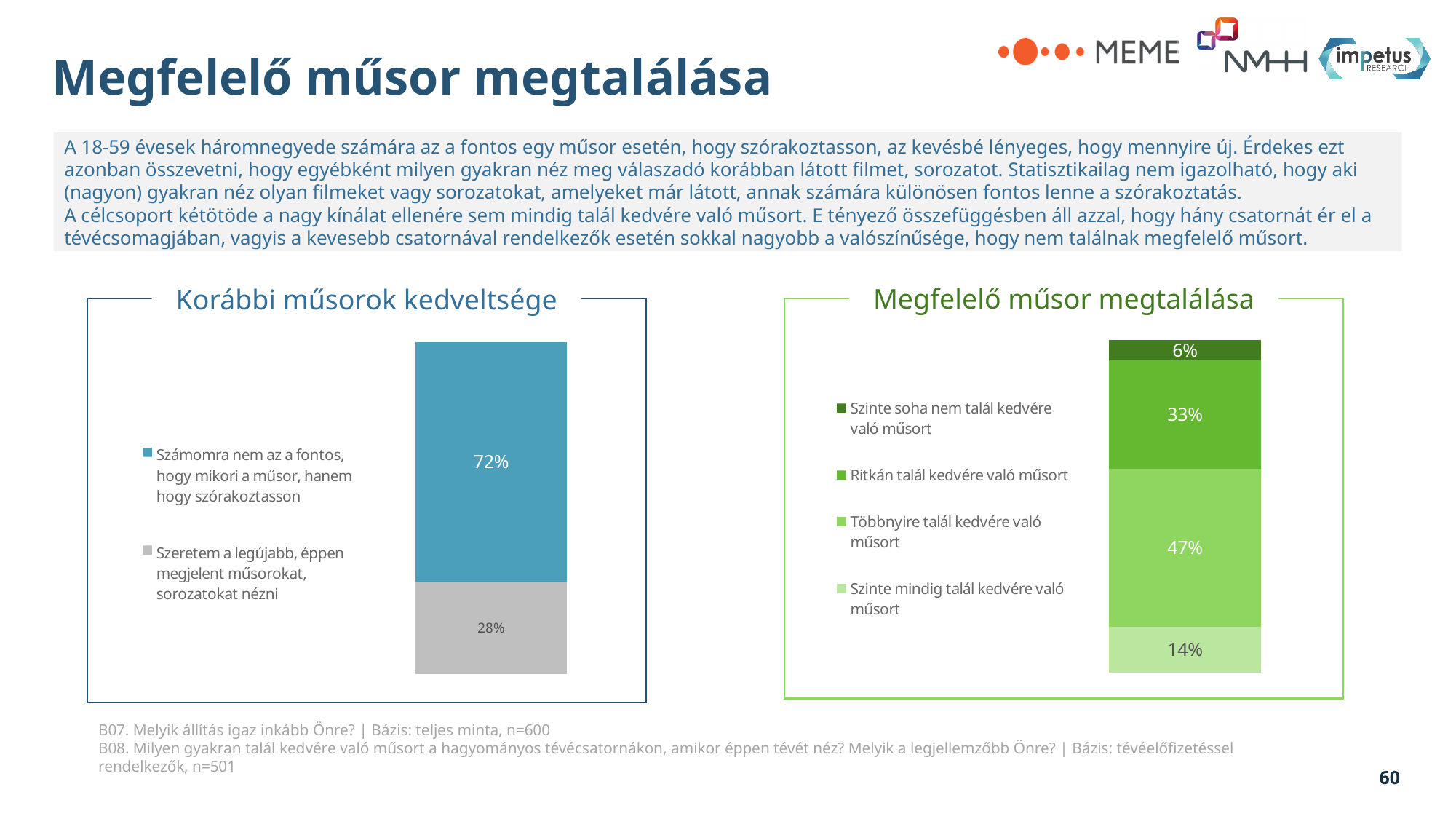
In the chart titled "Megfelelő műsor megtalálása", what percentage is shown for "Szinte mindig talál kedvére való műsort"? 14% In the chart titled "Megfelelő műsor megtalálása", which category has the highest value? Többnyire talál kedvére való műsort In the chart titled "Korábbi műsorok kedveltsége", how many series does the legend list? 2 In the chart titled "Megfelelő műsor megtalálása", how many series does the legend list? 4 In the chart titled "Korábbi műsorok kedveltsége", what is the difference between the two segments' values? 44 percentage points In the chart titled "Megfelelő műsor megtalálása", which is larger: "Ritkán talál kedvére való műsort" or "Szinte mindig talál kedvére való műsort"? Ritkán talál kedvére való műsort In the chart titled "Korábbi műsorok kedveltsége", what percentage is shown for "Számomra nem az a fontos, hogy mikori a műsor, hanem hogy szórakoztasson"? 72% What kind of chart is the chart titled "Megfelelő műsor megtalálása"? Stacked bar chart In the chart titled "Megfelelő műsor megtalálása", which category has the lowest value? Szinte soha nem talál kedvére való műsort In the chart titled "Megfelelő műsor megtalálása", what percentage is shown for "Szinte soha nem talál kedvére való műsort"? 6% In the chart titled "Korábbi műsorok kedveltsége", what percentage is shown for "Szeretem a legújabb, éppen megjelent műsorokat, sorozatokat nézni"? 28% In the chart titled "Megfelelő műsor megtalálása", what percentage is shown for "Ritkán talál kedvére való műsort"? 33%